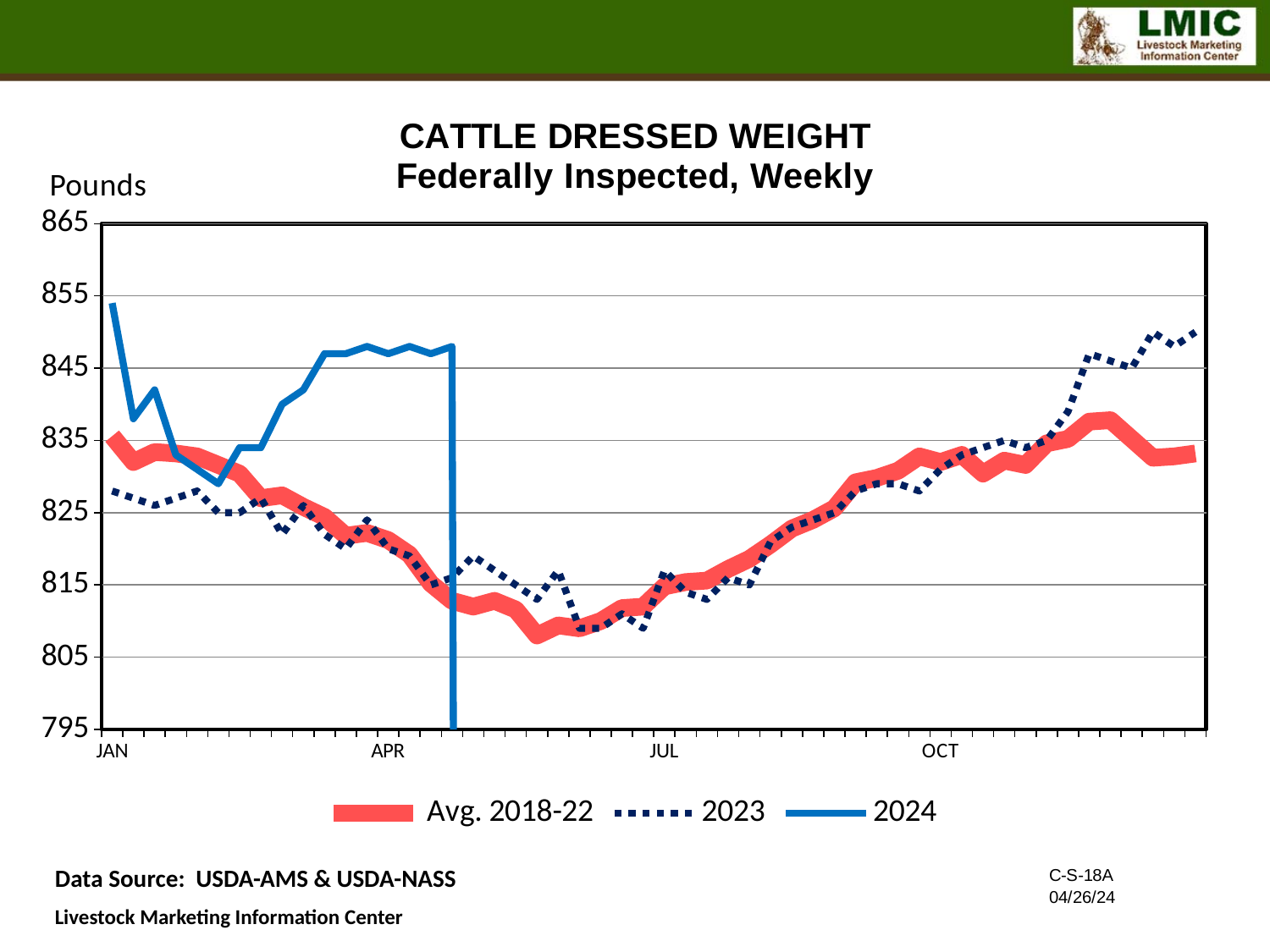
Does the Avg. 2018-22 series rise or fall from January to July? fall Is the 2024 value at the start of January greater or less than 845? greater At the start of January, which series is higher: 2024 or 2023? 2024 Is the 2023 value at the start of January greater or less than 835? less How many series does the legend list? 3 What unit is shown on the vertical axis label? Pounds What kind of chart is shown on the slide? Line chart Is the 2023 value at the end of the year (late December) greater or less than 845? greater At the start of April, which series is higher: 2024 or Avg. 2018-22? 2024 What is the title of the chart? CATTLE DRESSED WEIGHT Federally Inspected, Weekly How many month labels are shown on the x axis? 4